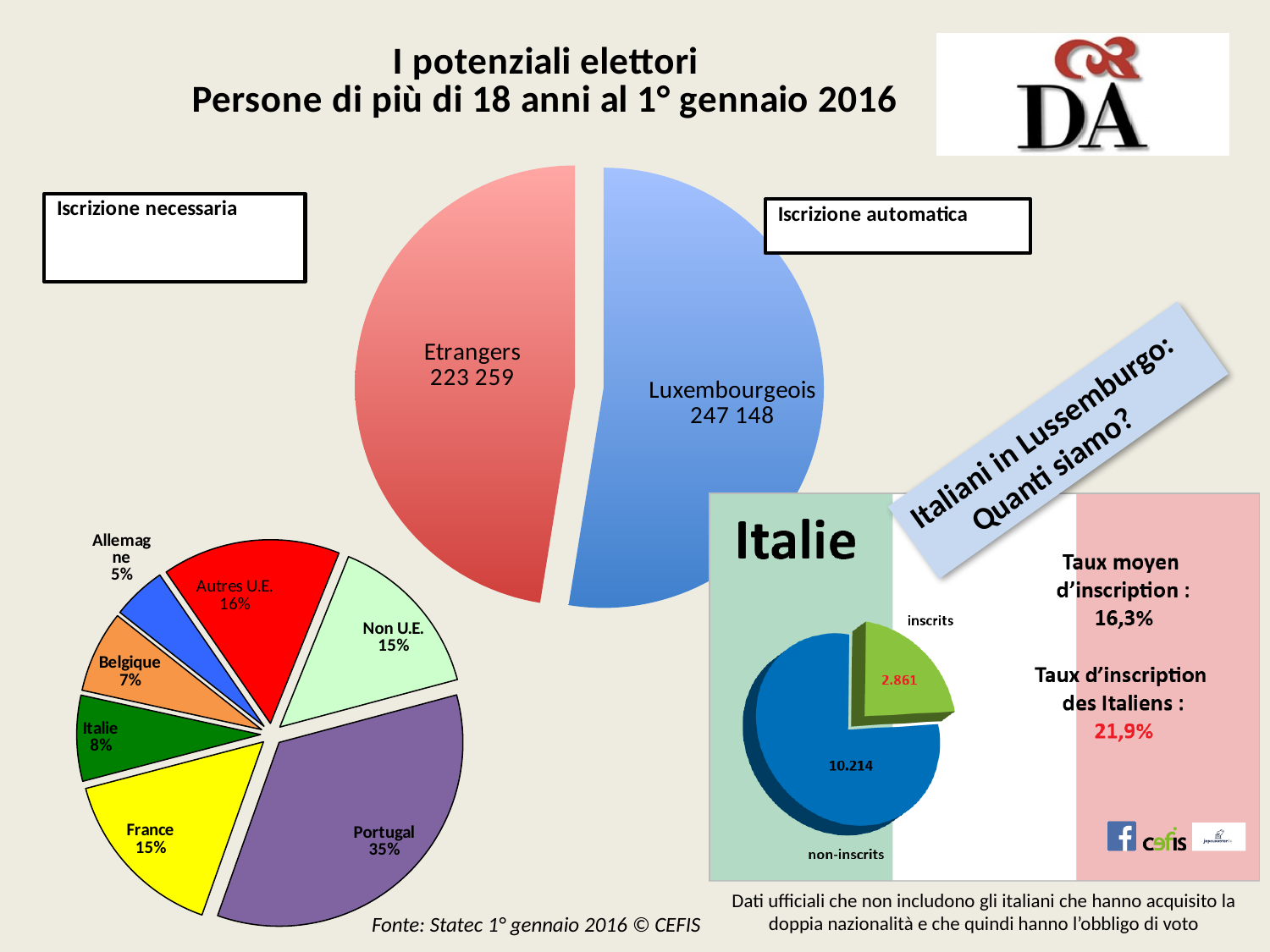
In the large central pie chart, what is the value for Etrangers? 223 259 In the bottom-right 'Italie' pie chart, what is the value for non-inscrits? 10.214 In the bottom-left pie chart, which nationality has the smallest share? Allemagne What type of chart is the large central chart? Pie chart In the large central pie chart, what is the value for Luxembourgeois? 247 148 In the large central pie chart, which slice is larger, Etrangers or Luxembourgeois? Luxembourgeois In the large central pie chart, what is the difference between the Luxembourgeois and Etrangers values? 23 889 In the bottom-left pie chart, which nationality has the largest share? Portugal In the bottom-left pie chart, how many slices are there? 7 In the bottom-right 'Italie' pie chart, what is the value for inscrits? 2.861 In the bottom-left pie chart, what is the difference between the shares of Autres U.E. and Italie? 8% In the bottom-left pie chart, what share does Portugal have? 35%